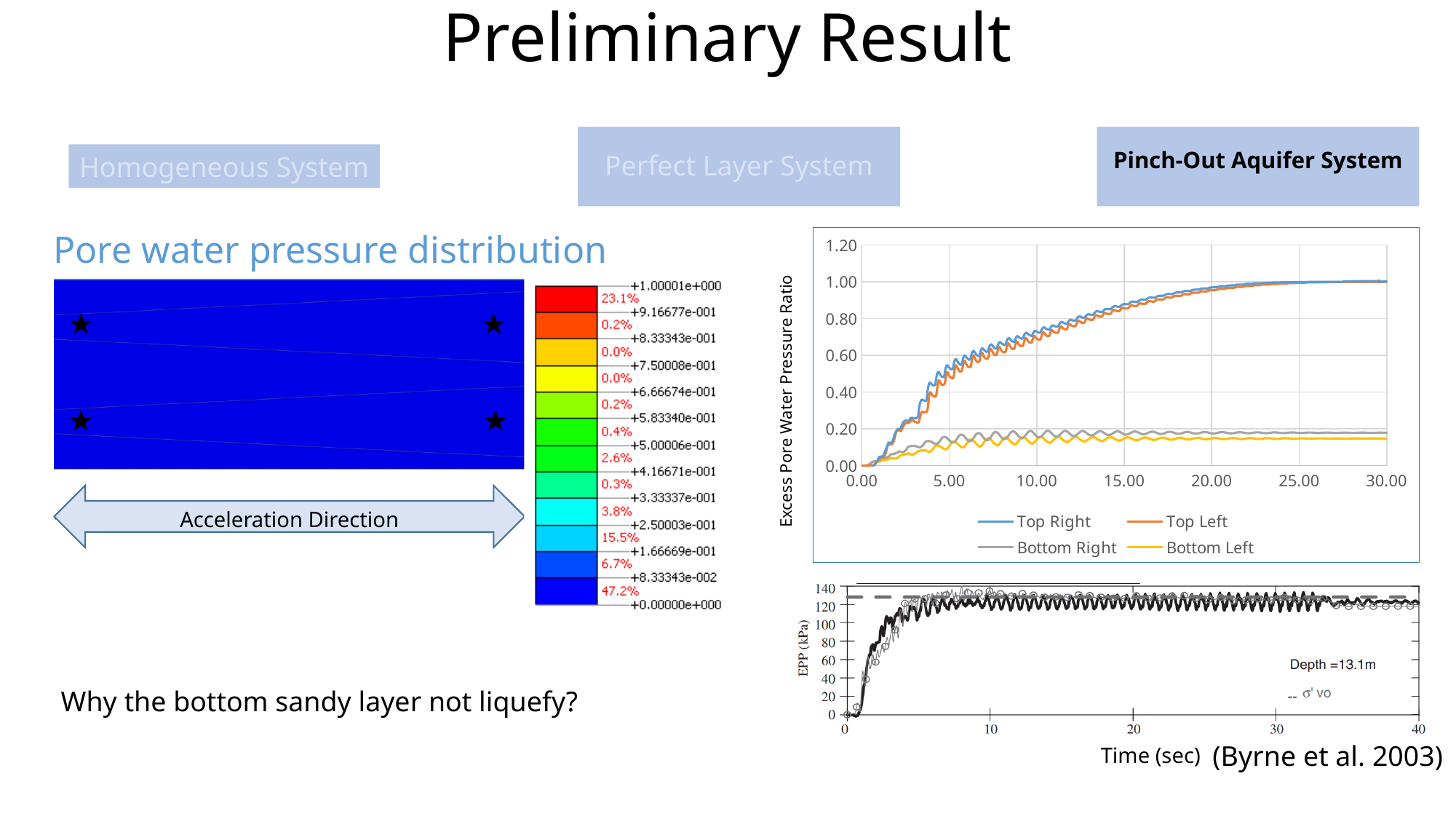
In the 'Excess Pore Water Pressure Ratio' chart, is the value for Top Left at time 5.00 greater or less than 0.60? less How many series does the legend of the 'Excess Pore Water Pressure Ratio' chart list? 4 In the 'Excess Pore Water Pressure Ratio' chart, does the Top Right series rise or fall as time increases from 0.00 to 30.00? rise In the 'Excess Pore Water Pressure Ratio' chart, is the value for Bottom Left at time 30.00 greater or less than 0.20? less What kind of chart is the 'EPP (kPa)' chart at the bottom right of the slide? line chart In the 'Excess Pore Water Pressure Ratio' chart, which is larger at time 30.00: Top Right or Bottom Right? Top Right In the 'Excess Pore Water Pressure Ratio' chart, which series has the lowest value at time 30.00? Bottom Left In the 'Excess Pore Water Pressure Ratio' chart, what is the label on the vertical axis? Excess Pore Water Pressure Ratio In the 'Excess Pore Water Pressure Ratio' chart, does the Bottom Right series stay above or below 0.40 over the whole time range? below What kind of chart is the 'Excess Pore Water Pressure Ratio' chart on the right of the slide? line chart In the 'EPP (kPa)' chart at the bottom right, what depth is stated in the annotation? Depth =13.1m